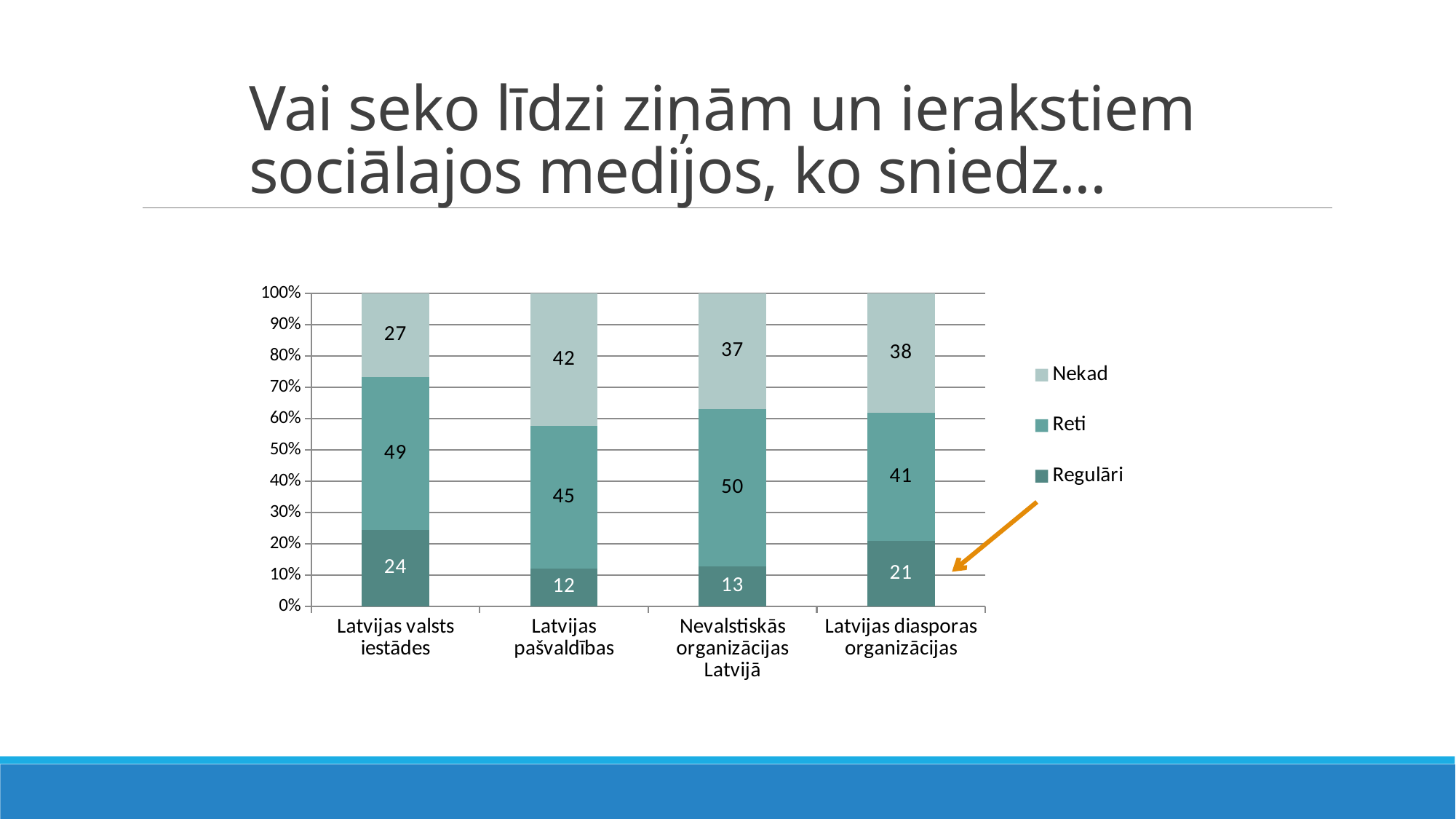
What is the value for "Regulāri" for Latvijas diasporas organizācijas? 21 How many series does the legend list? 3 How many categories are shown on the x axis? 4 What is the difference between the "Nekad" values for Latvijas pašvaldības and Latvijas valsts iestādes? 15 Which category has the highest "Regulāri" value? Latvijas valsts iestādes What is the value for "Nekad" for Latvijas pašvaldības? 42 Which is larger: the "Reti" value for Latvijas valsts iestādes or for Latvijas diasporas organizācijas? Latvijas valsts iestādes What kind of chart is shown on the slide? Stacked bar chart What is the value for "Reti" for Nevalstiskās organizācijas Latvijā? 50 Which category has the lowest "Nekad" value? Latvijas valsts iestādes What is the value for "Regulāri" for Latvijas valsts iestādes? 24